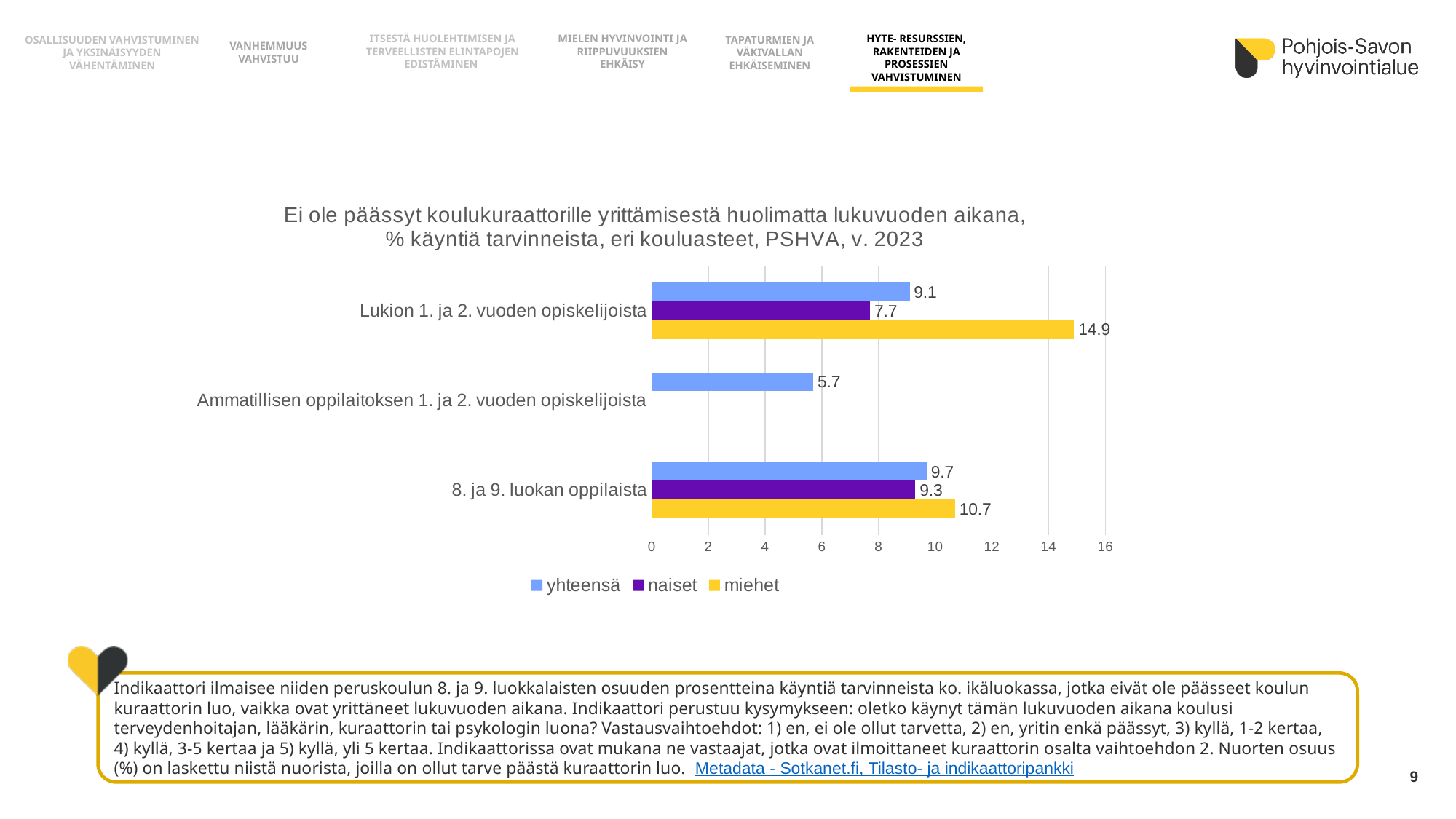
Which category has the highest miehet value? Lukion 1. ja 2. vuoden opiskelijoista What is the value for miehet among Lukion 1. ja 2. vuoden opiskelijoista? 14.9 What is the difference between the miehet and naiset values for Lukion 1. ja 2. vuoden opiskelijoista? 7.2 Which category has the lowest yhteensä value? Ammatillisen oppilaitoksen 1. ja 2. vuoden opiskelijoista Which series is shown in yellow in the legend? miehet Which is larger for 8. ja 9. luokan oppilaista: the yhteensä value or the miehet value? miehet What kind of chart is shown on the slide? bar chart What is the yhteensä value for Ammatillisen oppilaitoksen 1. ja 2. vuoden opiskelijoista? 5.7 What is the naiset value for 8. ja 9. luokan oppilaista? 9.3 How many series does the legend list? 3 Is the miehet value for 8. ja 9. luokan oppilaista greater or less than 10? greater How many categories are shown on the y axis of the chart? 3